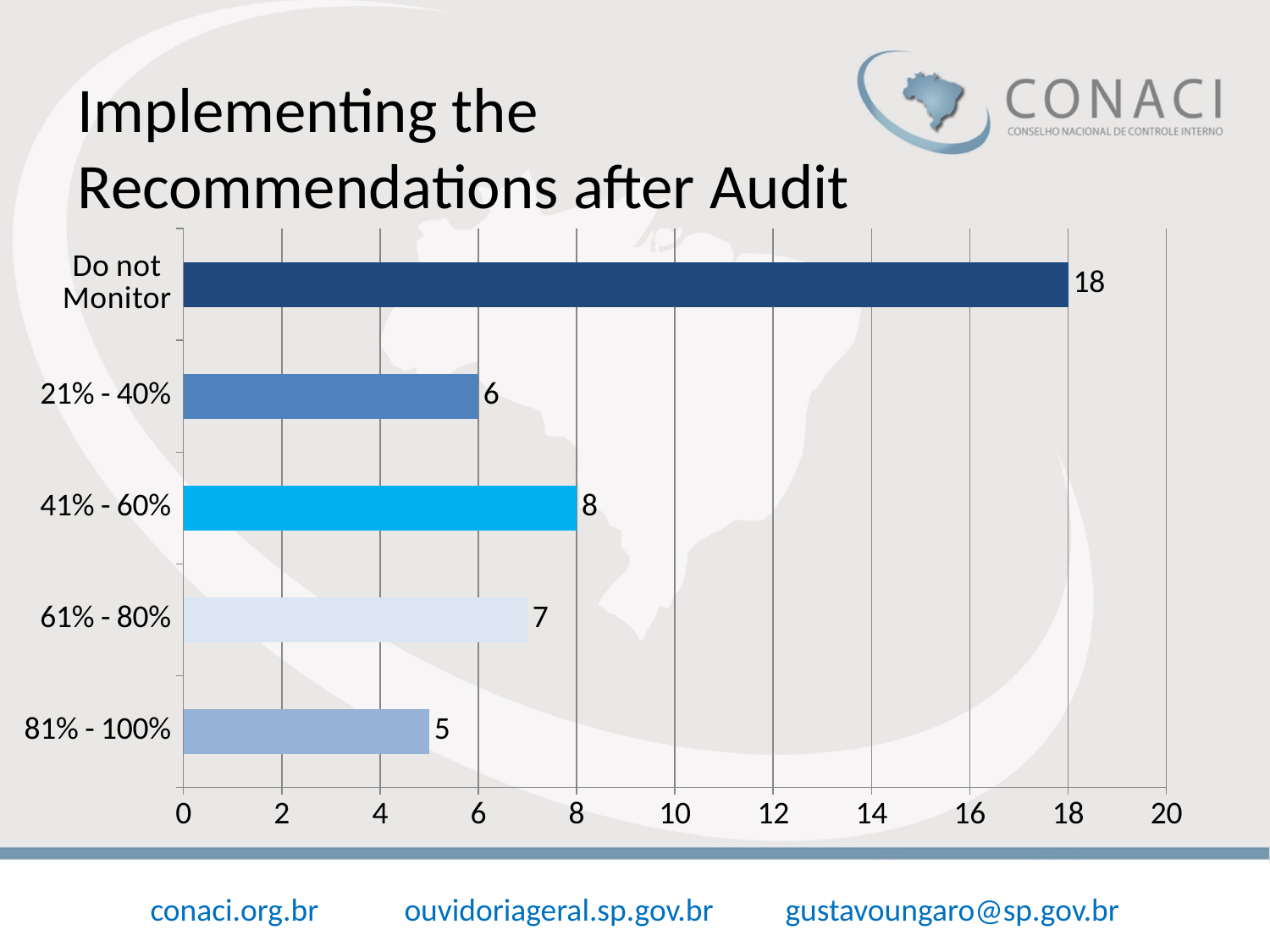
What is the value for "Do not Monitor"? 18 What is the value for the 41% - 60% category? 8 What is the value for the 81% - 100% category? 5 How many categories are shown in the chart? 5 What is the difference between the values for 61% - 80% and 21% - 40%? 1 Which category has the highest value? Do not Monitor Which category has the lowest value? 81% - 100% What is the difference between the values for "Do not Monitor" and 41% - 60%? 10 What is the title of the slide containing the chart? Implementing the Recommendations after Audit Which is larger, the value for 21% - 40% or the value for 41% - 60%? 41% - 60% What kind of chart is shown on the slide? bar chart Is the value for "Do not Monitor" greater or less than 10? greater